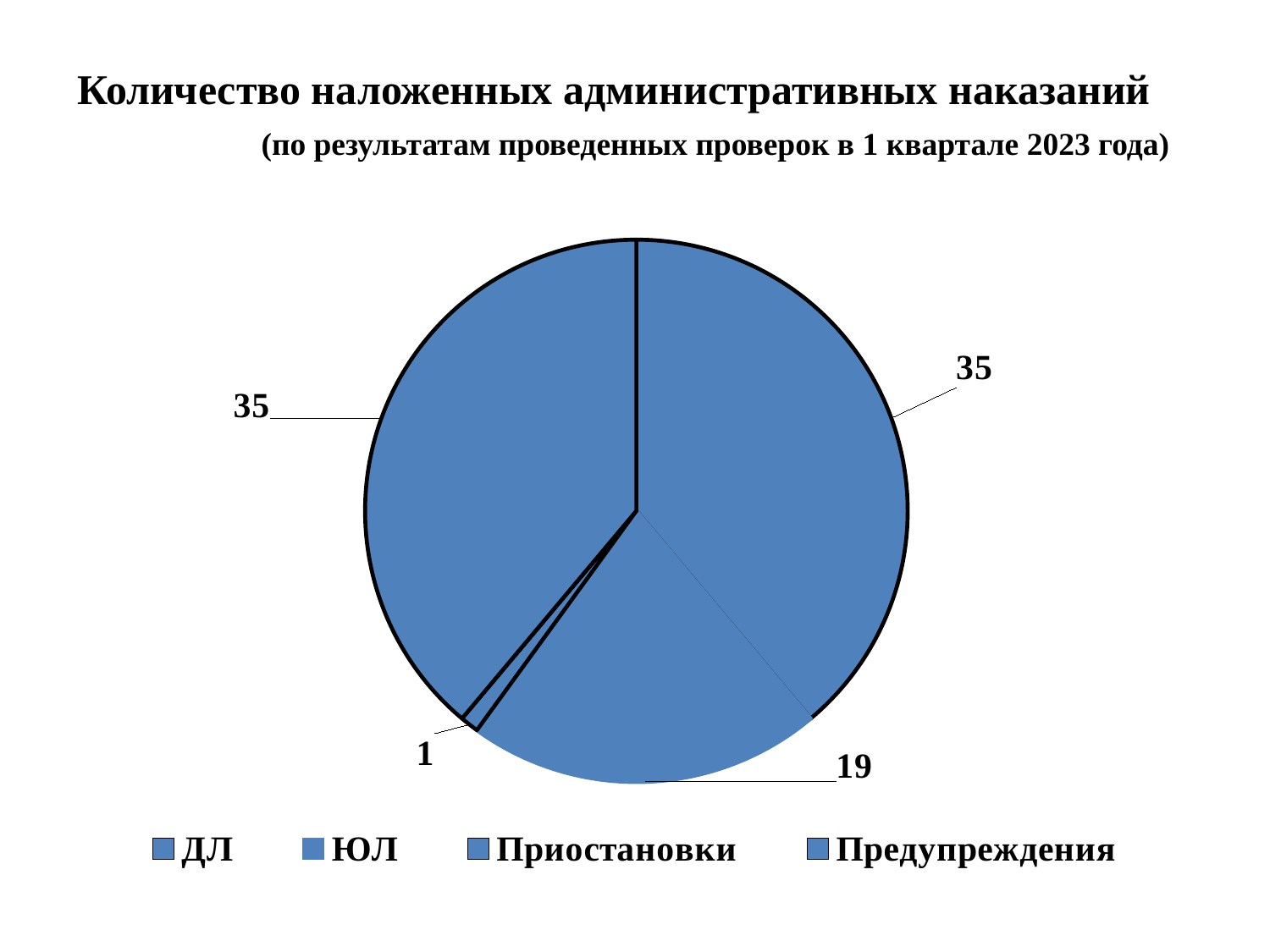
How many slices does the pie chart have? 4 What is the largest value labelled on the pie chart? 35 What is the smallest value labelled on the pie chart? 1 Which is larger: the slice labelled 19 or the slice labelled 1? 19 What is the difference between the largest labelled value (35) and the slice labelled 19? 16 What is the difference between the slice labelled 19 and the slice labelled 1? 18 What is the main title of the chart on the slide? Количество наложенных административных наказаний Which period does the chart subtitle say the data refers to? 1 квартал 2023 года What kind of chart is shown on the slide? pie chart What is the total of all the values labelled on the pie chart? 90 How many slices of the pie chart are labelled with the value 35? 2 How many entries does the legend of the pie chart list? 4